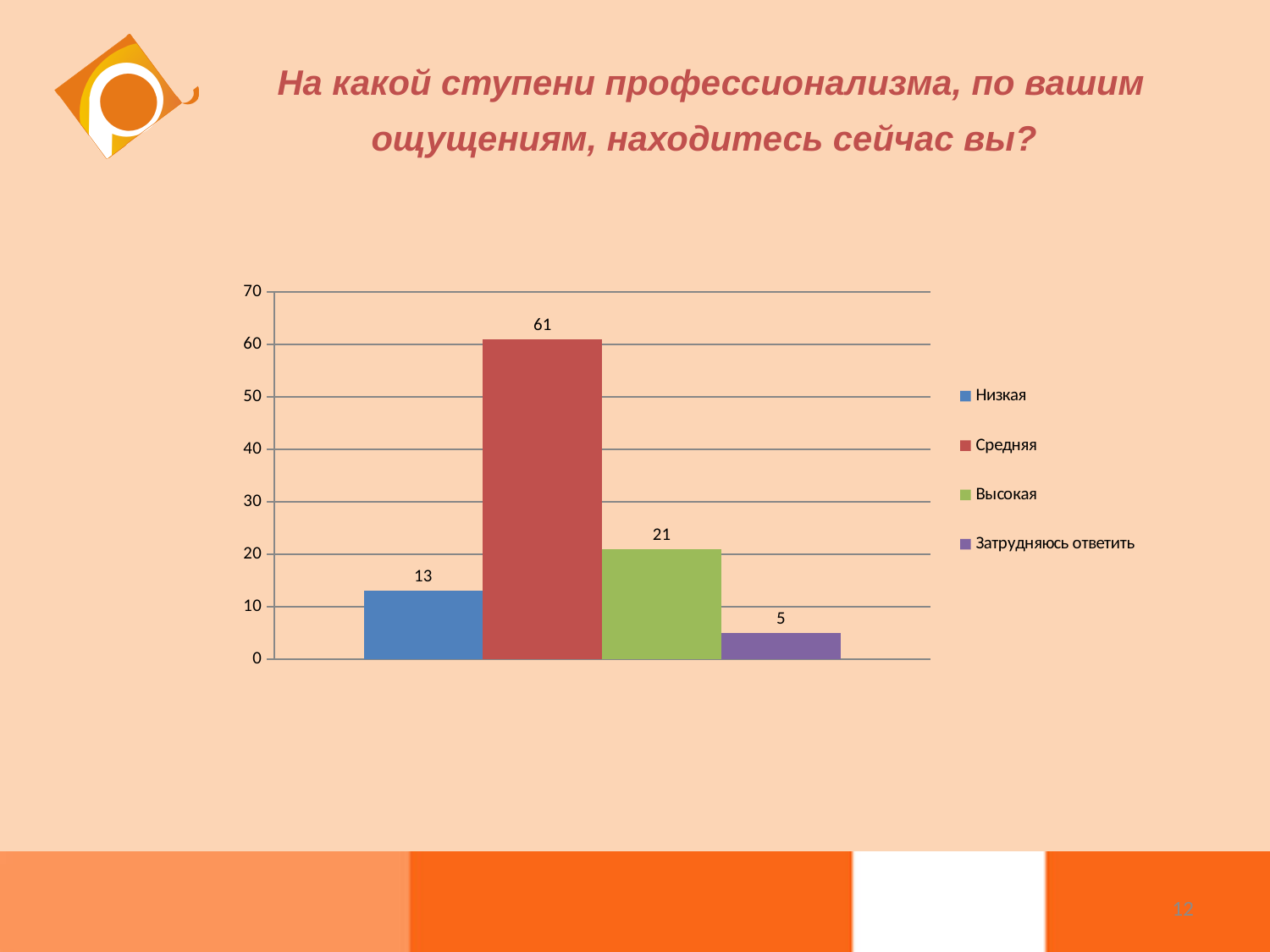
What is the value for Высокая? 21 How many series does the legend list? 4 What is the value for Низкая? 13 What is the value for Средняя? 61 What is the difference between the values for Средняя and Высокая? 40 What is the value for Затрудняюсь ответить? 5 Which category has the highest value? Средняя What kind of chart is shown on the slide? bar chart What colour is the bar for Средняя? red Which is larger, the value for Высокая or the value for Низкая? Высокая Is the value for Средняя greater or less than 50? greater Which category has the lowest value? Затрудняюсь ответить